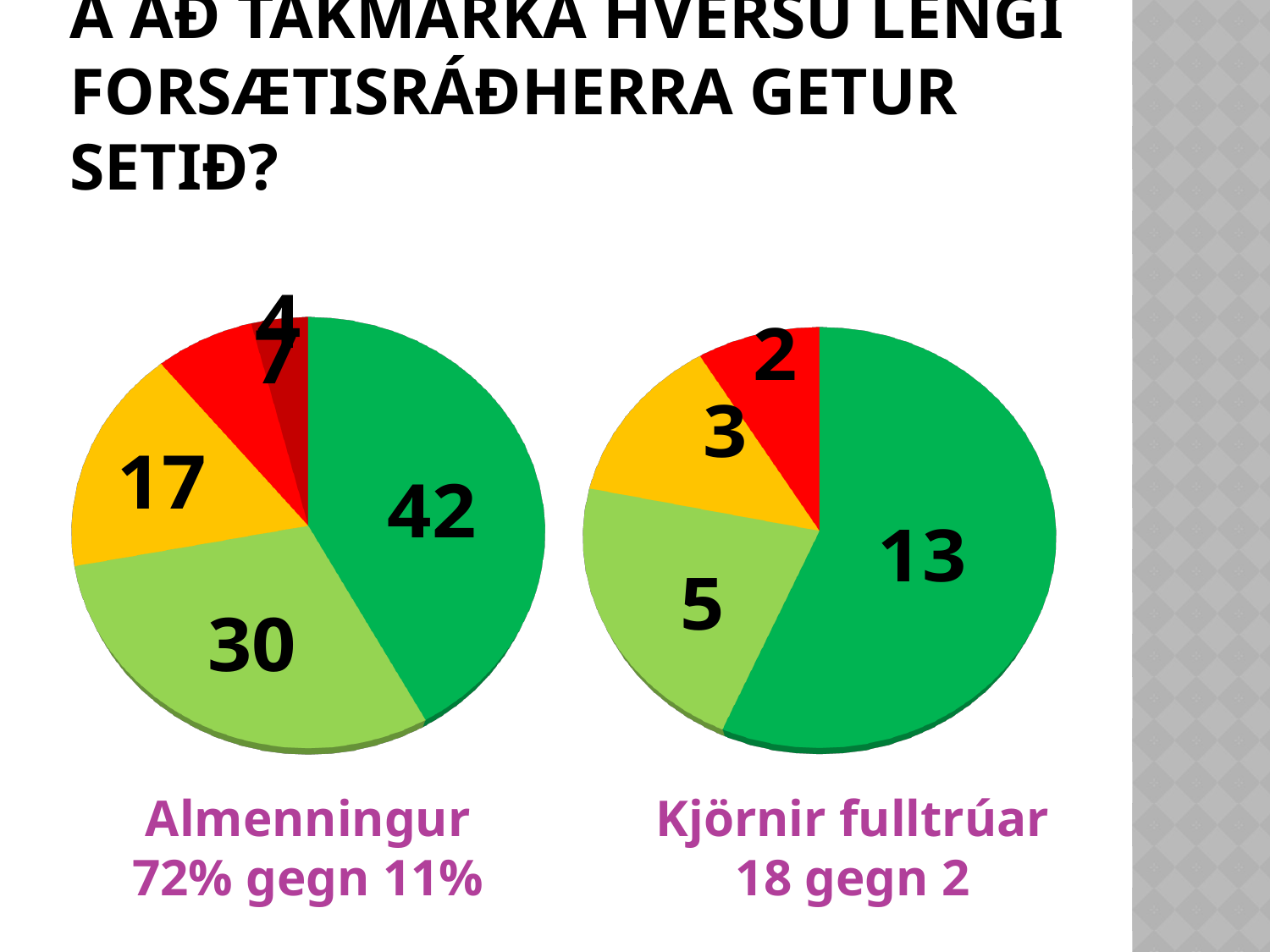
In the right pie chart (Kjörnir fulltrúar), what value is shown on the yellow slice? 3 How many slices does the right pie chart (Kjörnir fulltrúar) have? 4 In the left pie chart (Almenningur), what value is shown on the yellow slice? 17 What kind of chart is the left chart labelled Almenningur? pie chart In the left pie chart (Almenningur), what value is shown on the dark green slice? 42 In the right pie chart (Kjörnir fulltrúar), what value is shown on the dark green slice? 13 In the right pie chart (Kjörnir fulltrúar), which is larger, the light green slice or the yellow slice? the light green slice What text is shown below the right pie chart? Kjörnir fulltrúar 18 gegn 2 In the left pie chart (Almenningur), what is the difference between the dark green slice and the light green slice? 12 In the left pie chart (Almenningur), which slice has the largest value? the dark green slice (42) In the left pie chart (Almenningur), what value is shown on the light green slice? 30 In the right pie chart (Kjörnir fulltrúar), which slice has the smallest value? the red slice (2)